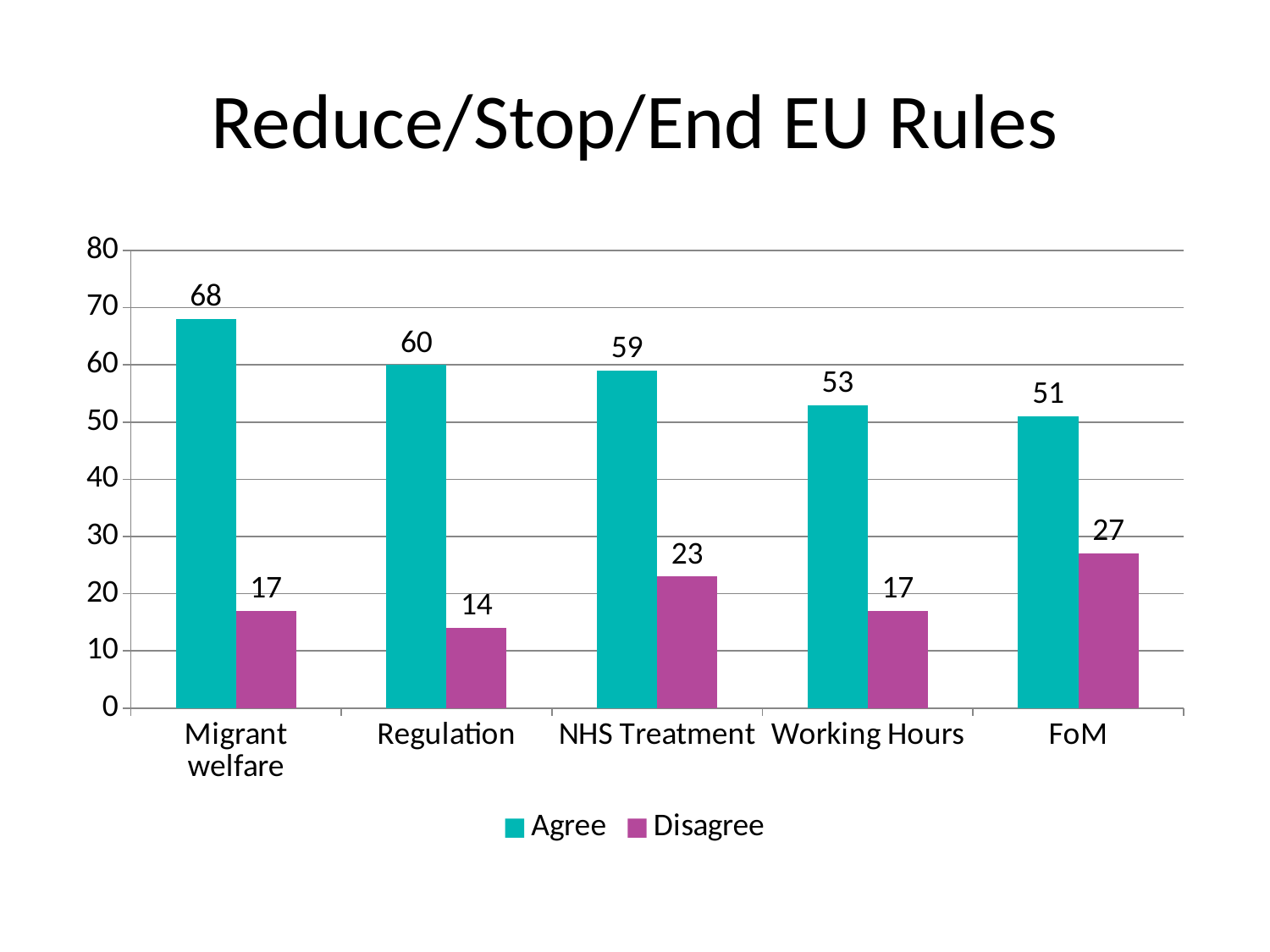
What is the Agree value for Migrant welfare? 68 What is the difference between the Agree and Disagree values for Working Hours? 36 Which is larger, the Disagree value for FoM or the Disagree value for NHS Treatment? FoM Is the Agree value for Regulation greater or less than 50? greater How many categories are shown on the x axis? 5 Which category has the lowest Disagree value? Regulation What is the title of the chart? Reduce/Stop/End EU Rules What is the Disagree value for NHS Treatment? 23 Which category has the highest Agree value? Migrant welfare How many series does the legend list? 2 What is the Agree value for FoM? 51 What kind of chart is shown on the slide? bar chart